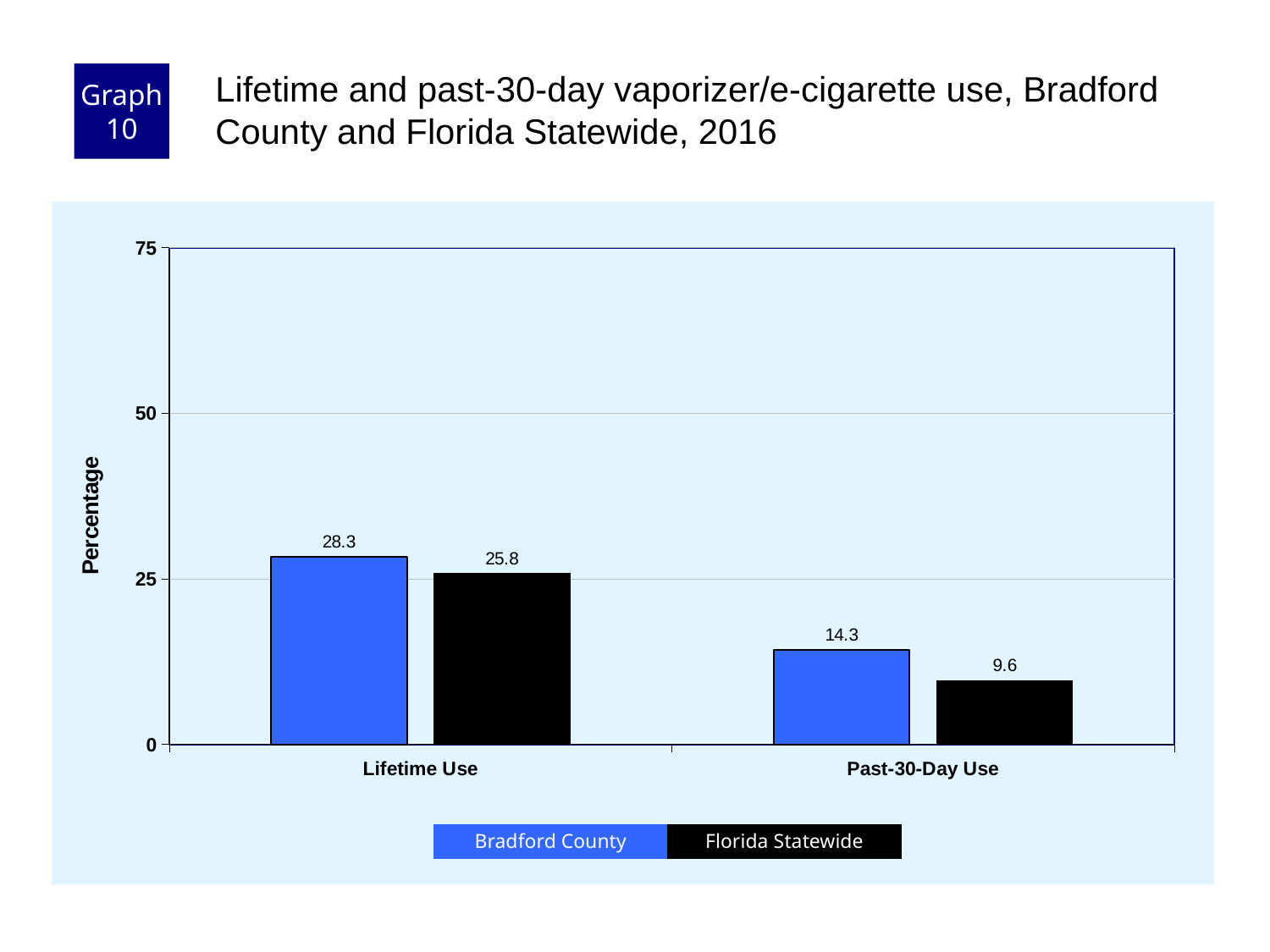
What is the Florida Statewide value for Past-30-Day Use? 9.6 What is the difference between the Bradford County and Florida Statewide values for Lifetime Use? 2.5 What is the Bradford County value for Past-30-Day Use? 14.3 How many series does the legend list? 2 What is the difference between the Bradford County and Florida Statewide values for Past-30-Day Use? 4.7 Which bar has the highest value on the chart? Bradford County, Lifetime Use Which bar has the lowest value on the chart? Florida Statewide, Past-30-Day Use For Lifetime Use, which is larger: Bradford County or Florida Statewide? Bradford County What is the Florida Statewide value for Lifetime Use? 25.8 What is the label on the vertical axis? Percentage What is the Bradford County value for Lifetime Use? 28.3 What kind of chart is shown on the slide? Bar chart